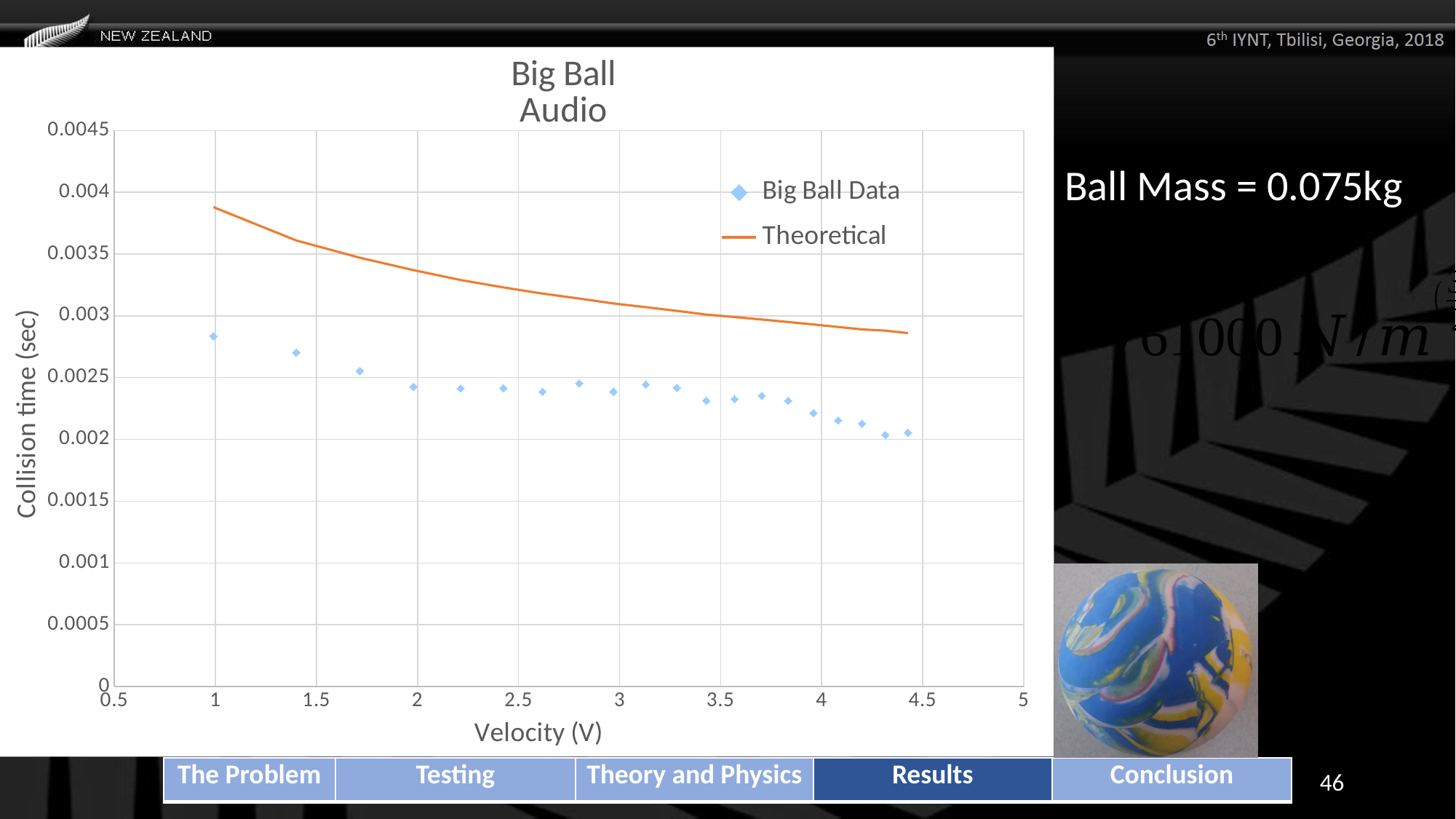
Is the Big Ball Data collision time at the highest velocity (around 4.5) greater or less than 0.0025? less What is the title of the chart? Big Ball Audio Is the Big Ball Data collision time at a velocity of 1 greater or less than 0.0025? greater Do the Big Ball Data points generally rise or fall as velocity increases? Fall At which velocity does the Big Ball Data series reach its highest collision time? 1 Is the Theoretical collision time at a velocity of 1 greater or less than 0.0035? greater At a velocity of 1, which series has the higher collision time, Big Ball Data or Theoretical? Theoretical As velocity increases along the x axis, does the Theoretical line rise or fall? Fall What are the two series named in the chart legend? Big Ball Data and Theoretical What kind of chart is shown on the slide? Scatter chart How many series does the chart legend list? 2